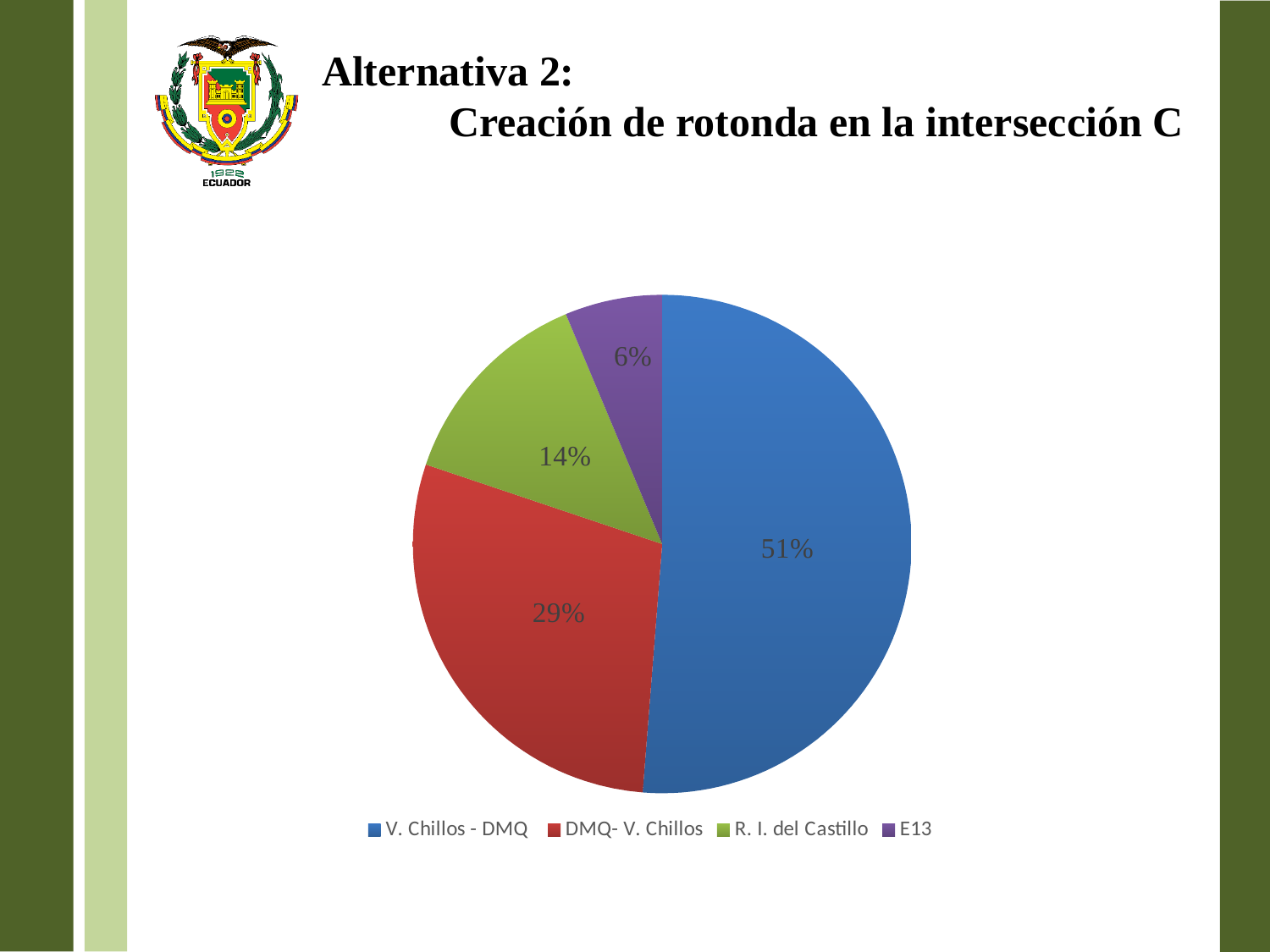
Which is larger, the slice for R. I. del Castillo or the slice for E13? R. I. del Castillo Which category has the smallest slice of the pie? E13 What colour is the slice for DMQ- V. Chillos? red How many slices does the pie chart have? 4 What kind of chart is shown on the slide? pie chart What share of the pie does DMQ- V. Chillos have? 29% What share of the pie does V. Chillos - DMQ have? 51% How many entries does the legend list? 4 What is the difference in percentage points between V. Chillos - DMQ and DMQ- V. Chillos? 22 What share of the pie does E13 have? 6% Which category has the largest slice of the pie? V. Chillos - DMQ